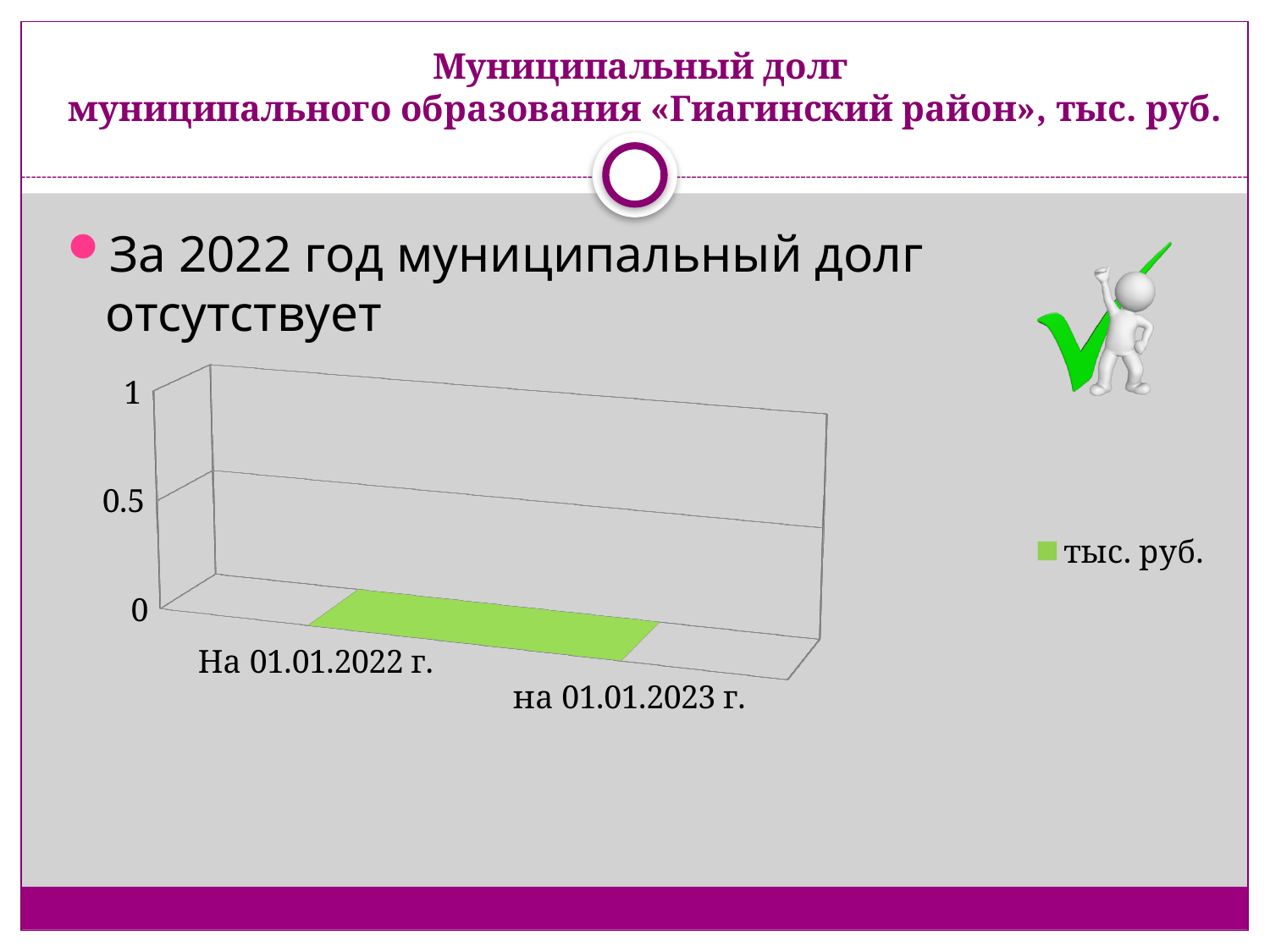
How many categories are shown on the x axis of the chart? 2 What kind of chart is shown on the slide? line chart What is the value for на 01.01.2023 г. in the chart? 0 How many series does the chart legend list? 1 Is the value for На 01.01.2022 г. greater or less than 0.5? less Is the value for на 01.01.2023 г. greater or less than 0.5? less What is the name of the series in the chart legend? тыс. руб. What is the highest tick value shown on the vertical axis of the chart? 1 What is the value for На 01.01.2022 г. in the chart? 0 What is the label of the first category on the x axis of the chart? На 01.01.2022 г.